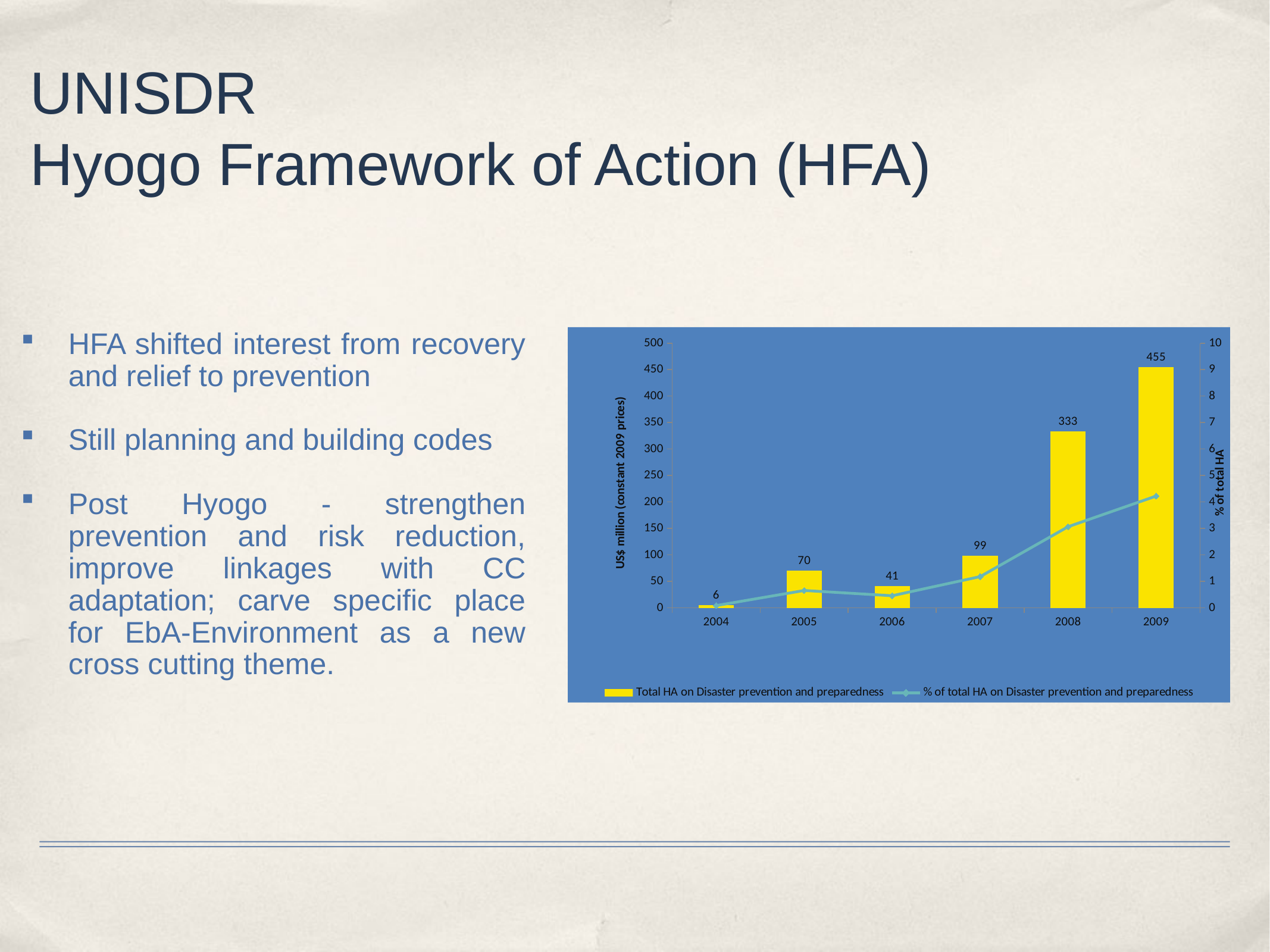
Which year has the highest Total HA on Disaster prevention and preparedness? 2009 Which is larger, the Total HA on Disaster prevention and preparedness for 2005 or for 2006? 2005 Is the % of total HA on Disaster prevention and preparedness for 2009 greater or less than 3? greater How many years are shown on the x axis of the chart? 6 What is the value of Total HA on Disaster prevention and preparedness for 2009? 455 What is the value of Total HA on Disaster prevention and preparedness for 2004? 6 Which year has the lowest Total HA on Disaster prevention and preparedness? 2004 What is the label of the left vertical axis of the chart? US$ million (constant 2009 prices) What is the value of Total HA on Disaster prevention and preparedness for 2006? 41 Is the % of total HA on Disaster prevention and preparedness for 2005 greater or less than 2? less How many series does the chart legend list? 2 What is the difference in Total HA on Disaster prevention and preparedness between 2009 and 2008? 122